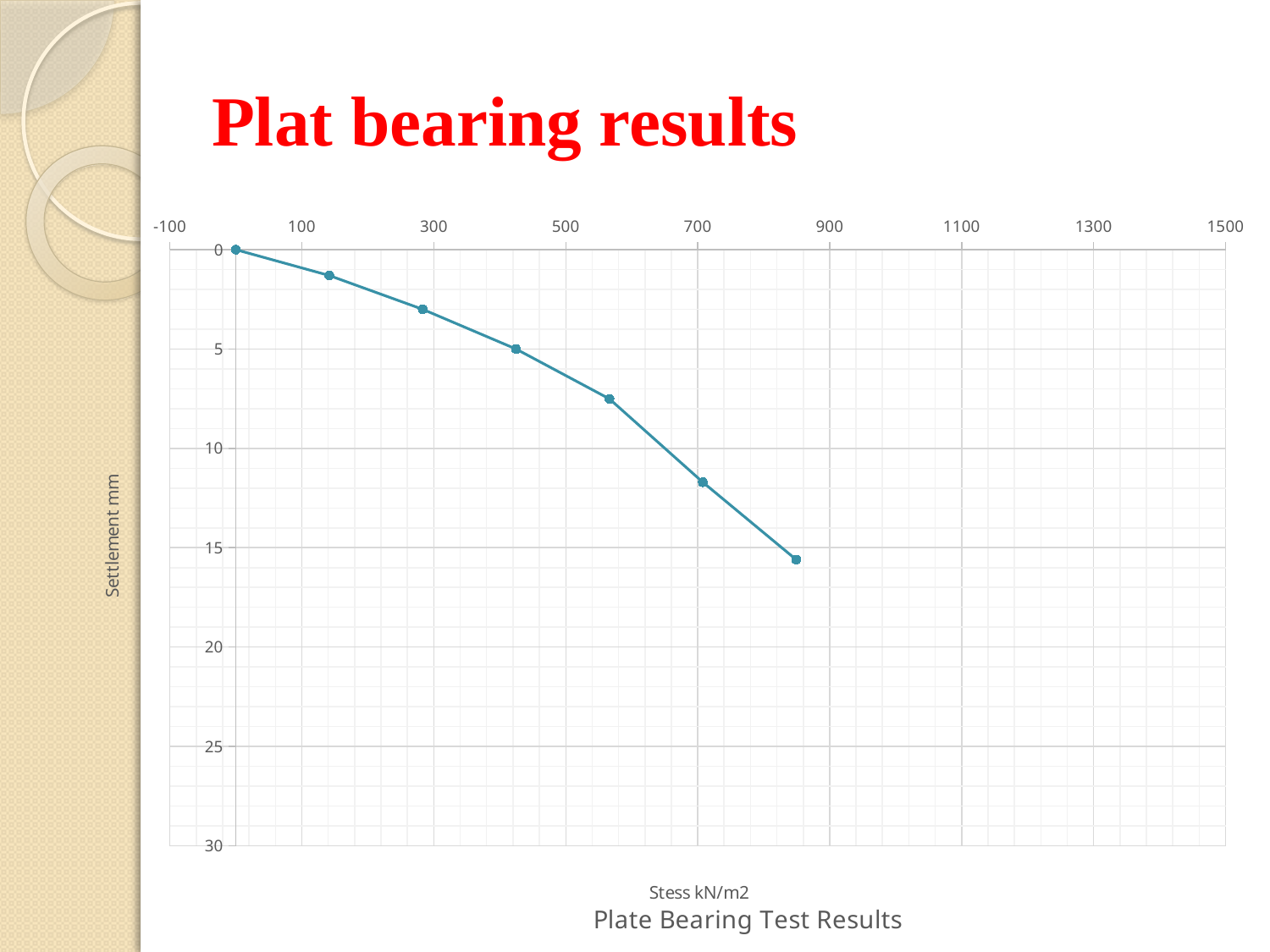
Is the settlement at a stress of about 560 kN/m2 greater or less than 10 mm? less Is the largest stress value plotted greater or less than 700 kN/m2? greater Is the settlement at a stress of about 700 kN/m2 greater or less than 10 mm? greater What kind of chart is shown on the slide? line chart How many data points are plotted on the chart? 7 What is the maximum value shown on the settlement axis? 30 What is the label of the horizontal axis? Stess kN/m2 As stress increases along the x axis, does settlement increase or decrease? increase What is the title shown beneath the chart? Plate Bearing Test Results